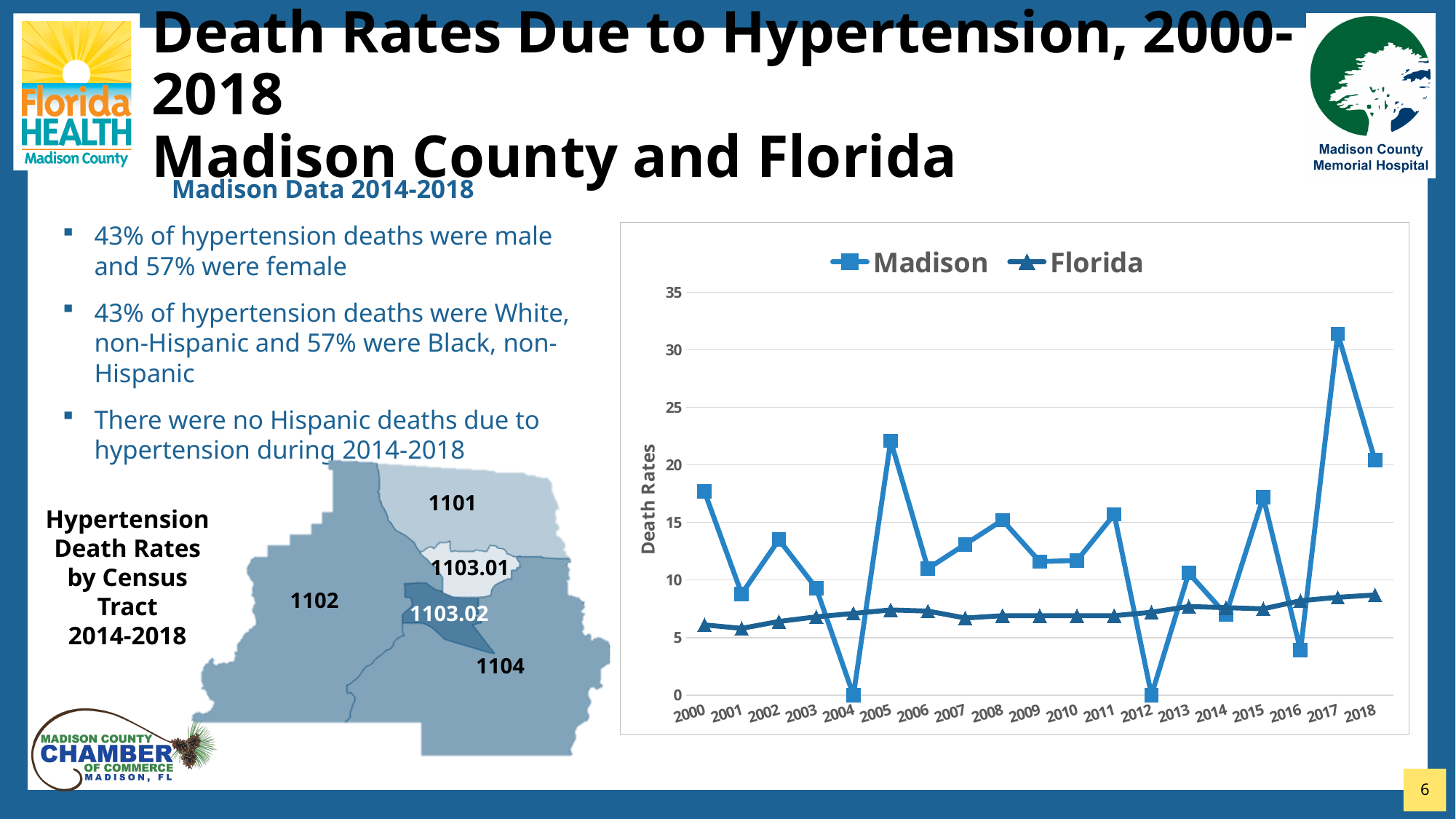
How many series does the legend of the chart list? 2 Is the Madison value for 2005 greater or less than 20? greater How many years are shown along the x axis of the chart? 19 Is the Florida value for 2018 greater or less than 10? less In 2016, which series has the larger value, Madison or Florida? Florida What kind of chart is shown on the right side of the slide? line chart What is the label of the vertical axis of the chart? Death Rates What are the two series named in the chart legend? Madison and Florida What is the Madison death rate value in 2004? 0 Does the Florida series generally rise or fall from 2000 to 2018? rise Is the Madison value for 2017 greater or less than 30? greater In which year does the Madison series reach its highest value? 2017